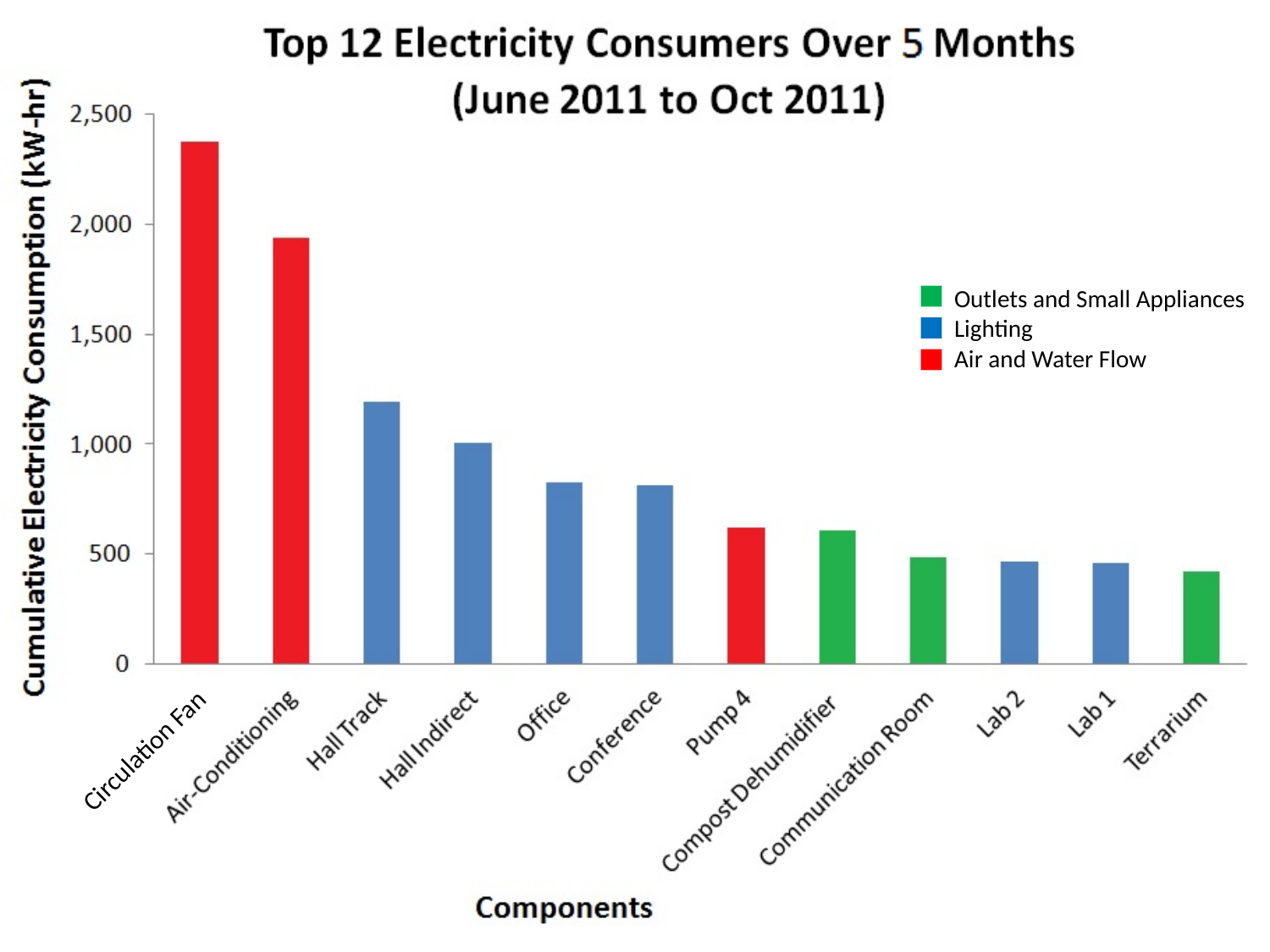
Which component has the lowest cumulative electricity consumption? Terrarium How many series does the legend list? 3 Which has the larger cumulative electricity consumption, Hall Track or Office? Hall Track Do the bar values rise or fall from left to right along the x axis? fall Is the value for Terrarium greater or less than 500? less Which component has the highest cumulative electricity consumption? Circulation Fan Which colour does the legend use for Lighting? blue What kind of chart is shown on the slide? bar chart How many components are plotted on the chart? 12 Is the value for Air-Conditioning greater or less than 2,000? less Is the value for Hall Track greater or less than 1,000? greater